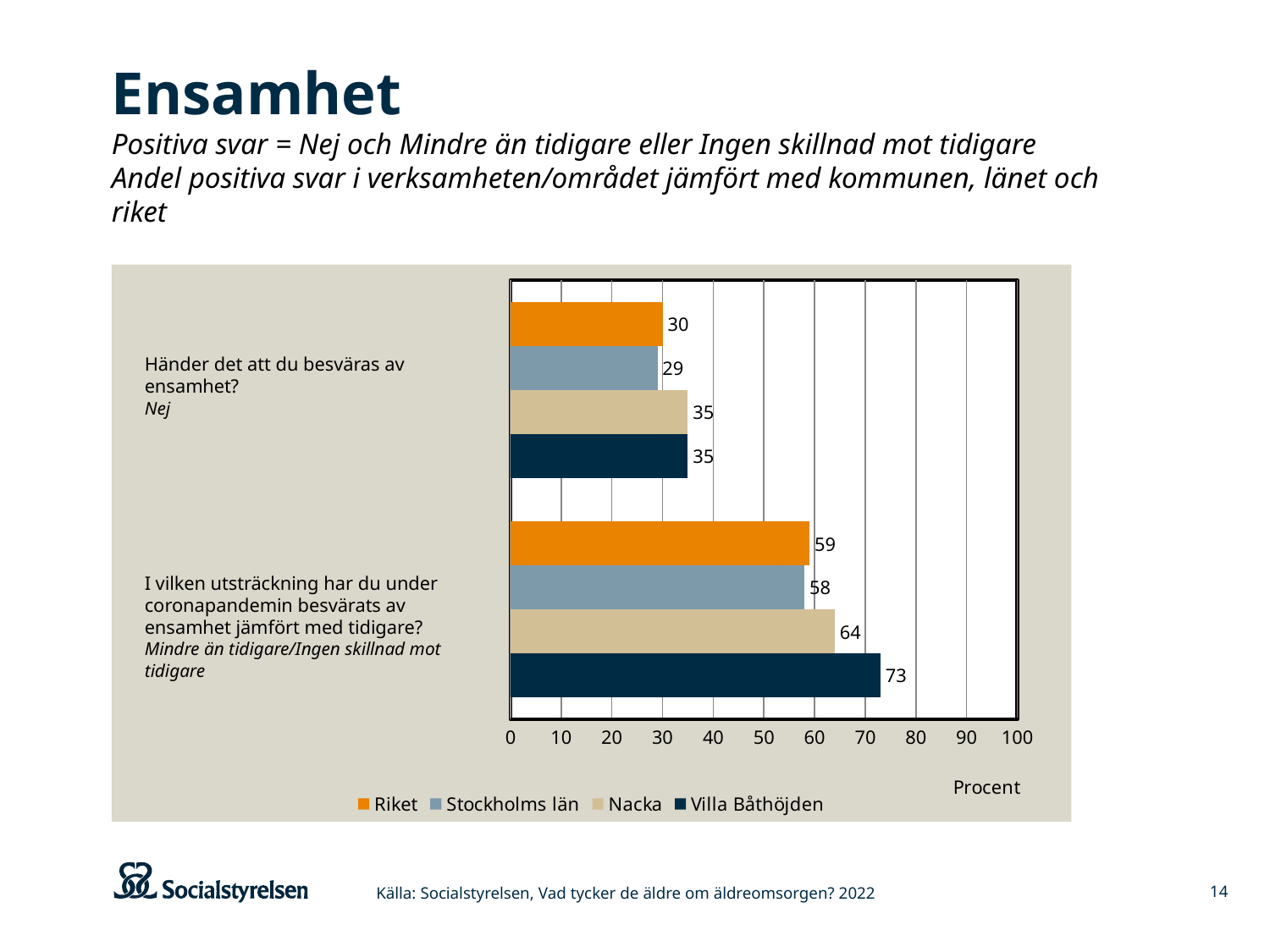
Which is larger on the question 'I vilken utsträckning har du under coronapandemin besvärats av ensamhet jämfört med tidigare?': Nacka or Riket? Nacka What is the value for Nacka on the question 'Händer det att du besväras av ensamhet?' 35 What is the value for Villa Båthöjden on the question 'I vilken utsträckning har du under coronapandemin besvärats av ensamhet jämfört med tidigare?' 73 Which series has the highest value on the question 'I vilken utsträckning har du under coronapandemin besvärats av ensamhet jämfört med tidigare?' Villa Båthöjden What is the value for Riket on the question 'Händer det att du besväras av ensamhet?' 30 How many series does the legend list? 4 What is the difference between Villa Båthöjden and Riket on the question 'I vilken utsträckning har du under coronapandemin besvärats av ensamhet jämfört med tidigare?' 14 Is the value for Villa Båthöjden on the question 'I vilken utsträckning har du under coronapandemin besvärats av ensamhet jämfört med tidigare?' greater or less than 70? greater What is the value for Stockholms län on the question 'I vilken utsträckning har du under coronapandemin besvärats av ensamhet jämfört med tidigare?' 58 Which series has the lowest value on the question 'Händer det att du besväras av ensamhet?' Stockholms län What is the label on the x axis of the chart? Procent What kind of chart is shown on the slide? Bar chart